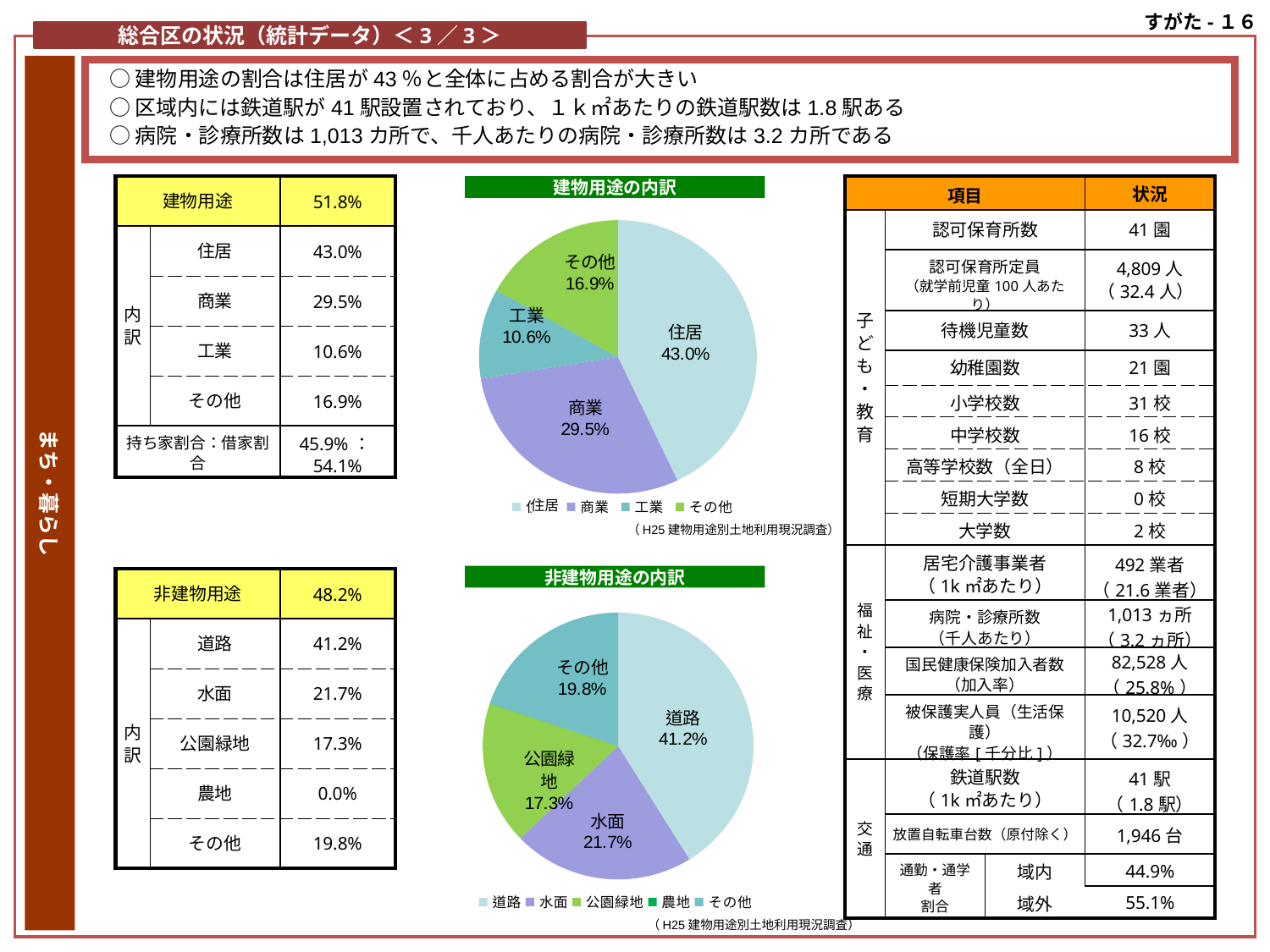
In the 建物用途の内訳 pie chart, what is the share for 工業? 10.6% What type of chart is the 非建物用途の内訳 chart? Pie chart In the 建物用途の内訳 pie chart, which category has the largest share? 住居 In the 建物用途の内訳 pie chart, what is the share for 住居? 43.0% In the 建物用途の内訳 pie chart, how many entries does the legend list? 4 In the 建物用途の内訳 pie chart, what is the difference between the shares of 商業 and その他? 12.6% In the 建物用途の内訳 pie chart, which category has the smallest share? 工業 In the 非建物用途の内訳 pie chart, what is the share for 公園緑地? 17.3% In the 非建物用途の内訳 pie chart, what is the difference between the shares of 道路 and 水面? 19.5% In the 非建物用途の内訳 pie chart, which is larger, 水面 or その他? 水面 In the 非建物用途の内訳 pie chart, how many entries does the legend list? 5 In the 非建物用途の内訳 pie chart, what is the share for 道路? 41.2%